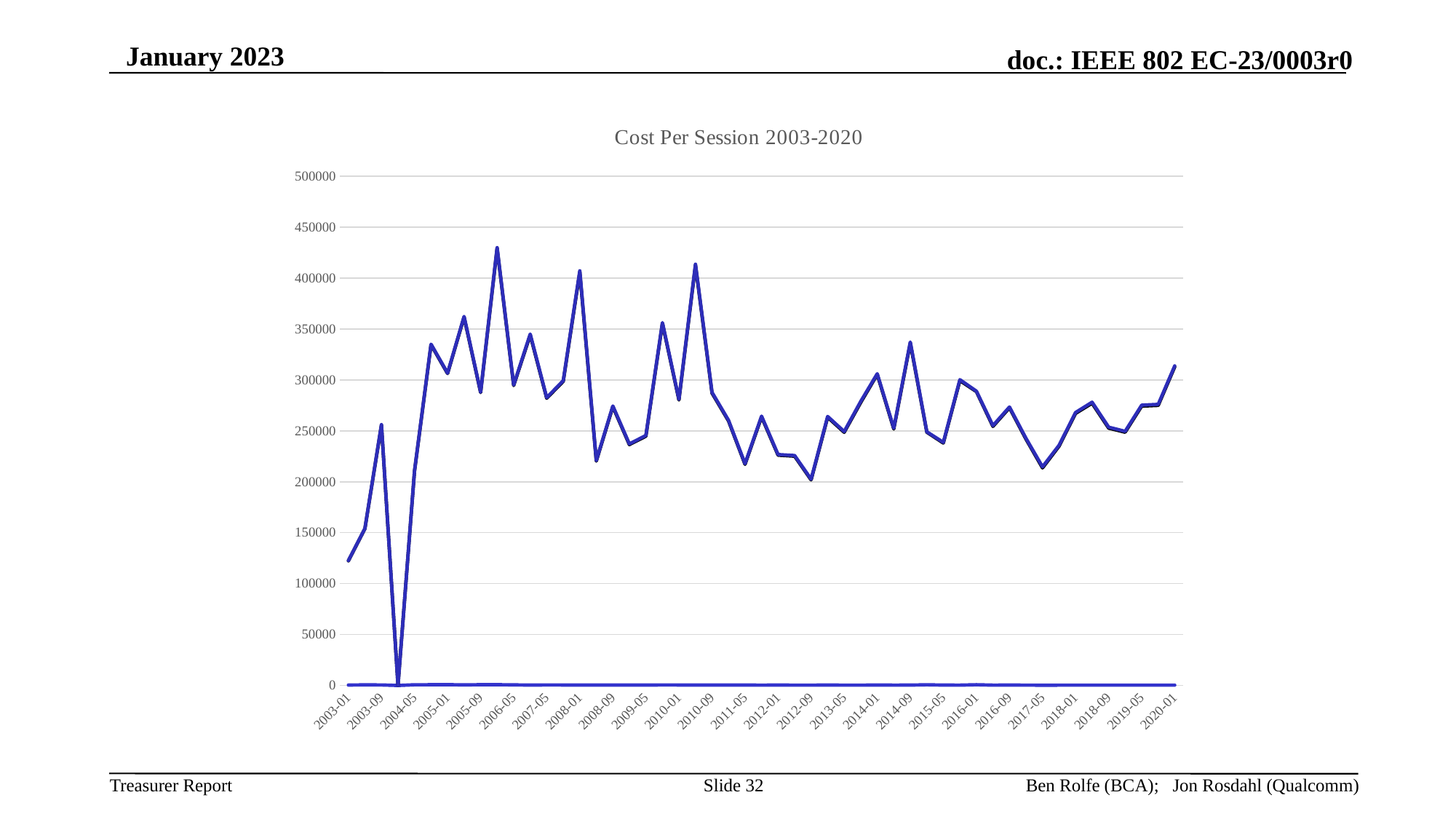
Is the cost per session for 2005-01 greater or less than 300000? greater Is the cost per session for 2017-05 greater or less than 250000? less Is the cost per session for 2003-01 greater or less than 100000? greater What is the title of the chart? Cost Per Session 2003-2020 Does the cost per session rise or fall from 2003-01 to 2003-09? rise What kind of chart is shown on the slide? line chart What is the highest value shown on the vertical axis? 500000